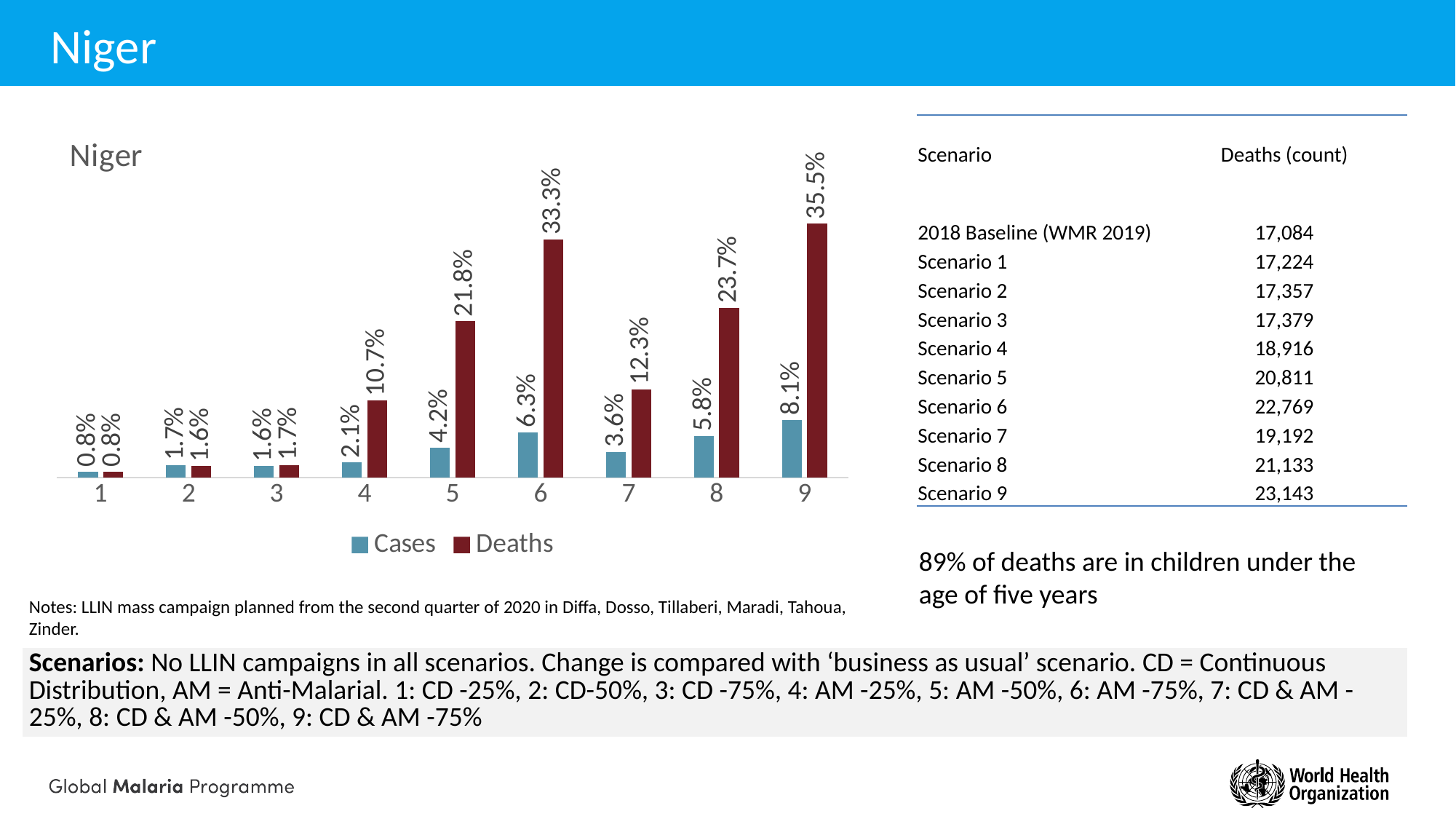
What is the Deaths value for scenario 4? 10.7% How many series does the chart legend list? 2 What is the difference between the Deaths value and the Cases value for scenario 6? 27.0% Which is larger for scenario 8: the Cases value or the Deaths value? Deaths What is the Cases value for scenario 5? 4.2% What is the Deaths value for scenario 9? 35.5% What are the two series named in the chart legend? Cases and Deaths What is the title of the chart? Niger What kind of chart is shown on the slide? Bar chart Which scenario has the highest Deaths value? 9 Which scenario has the lowest Cases value? 1 How many scenarios are shown on the x axis of the chart? 9